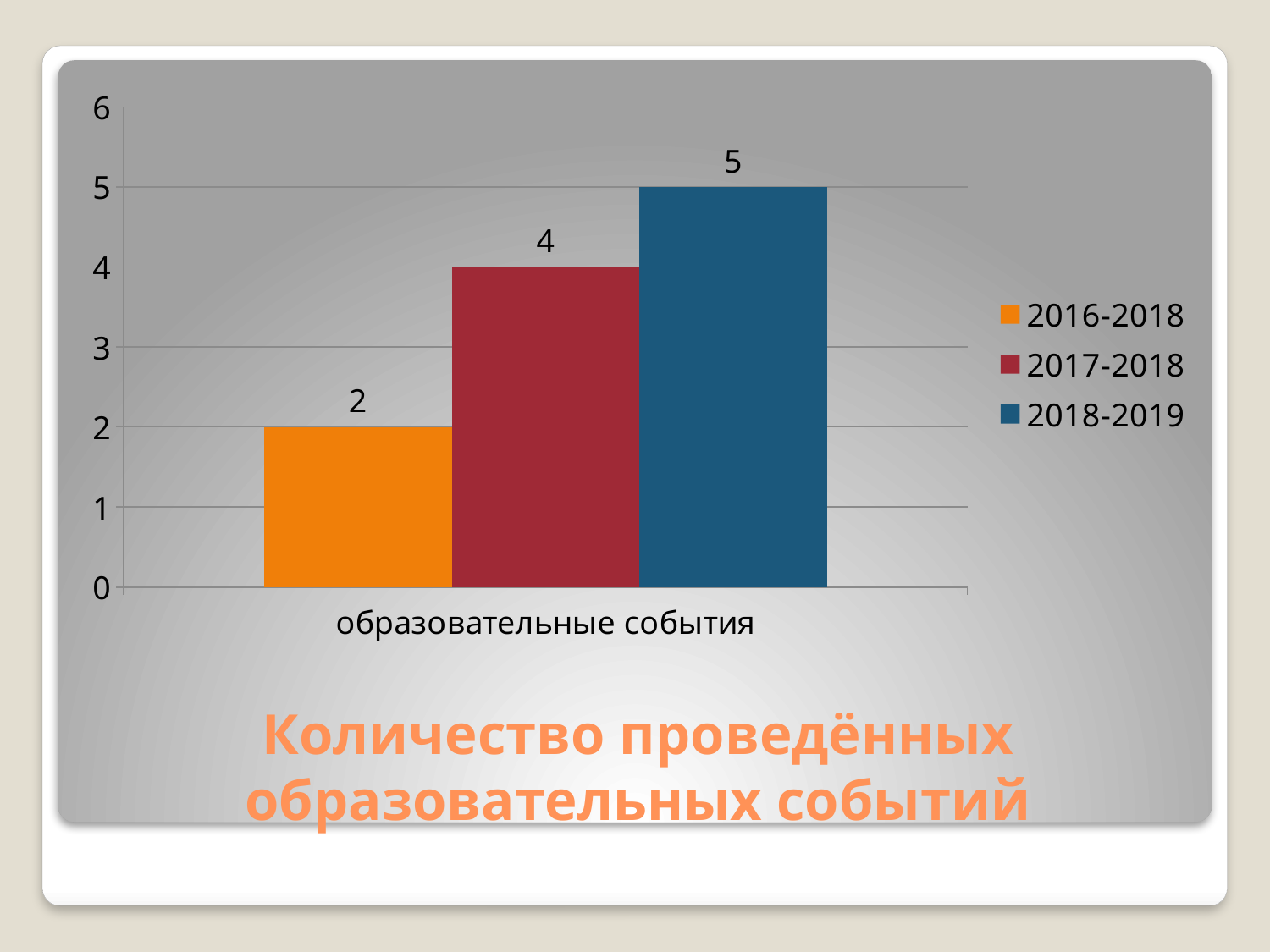
What kind of chart is shown on the slide? bar chart What is the value for the 2018-2019 series? 5 What is the difference between the 2018-2019 value and the 2016-2018 value? 3 What is the title of the chart? Количество проведённых образовательных событий Do the values rise or fall from the 2016-2018 series to the 2018-2019 series? rise Which series has the lowest value? 2016-2018 What is the difference between the 2017-2018 value and the 2016-2018 value? 2 Which is larger, the value for 2017-2018 or the value for 2018-2019? 2018-2019 Which series has the highest value? 2018-2019 How many series does the legend list? 3 What is the value for the 2017-2018 series? 4 What is the value for the 2016-2018 series? 2